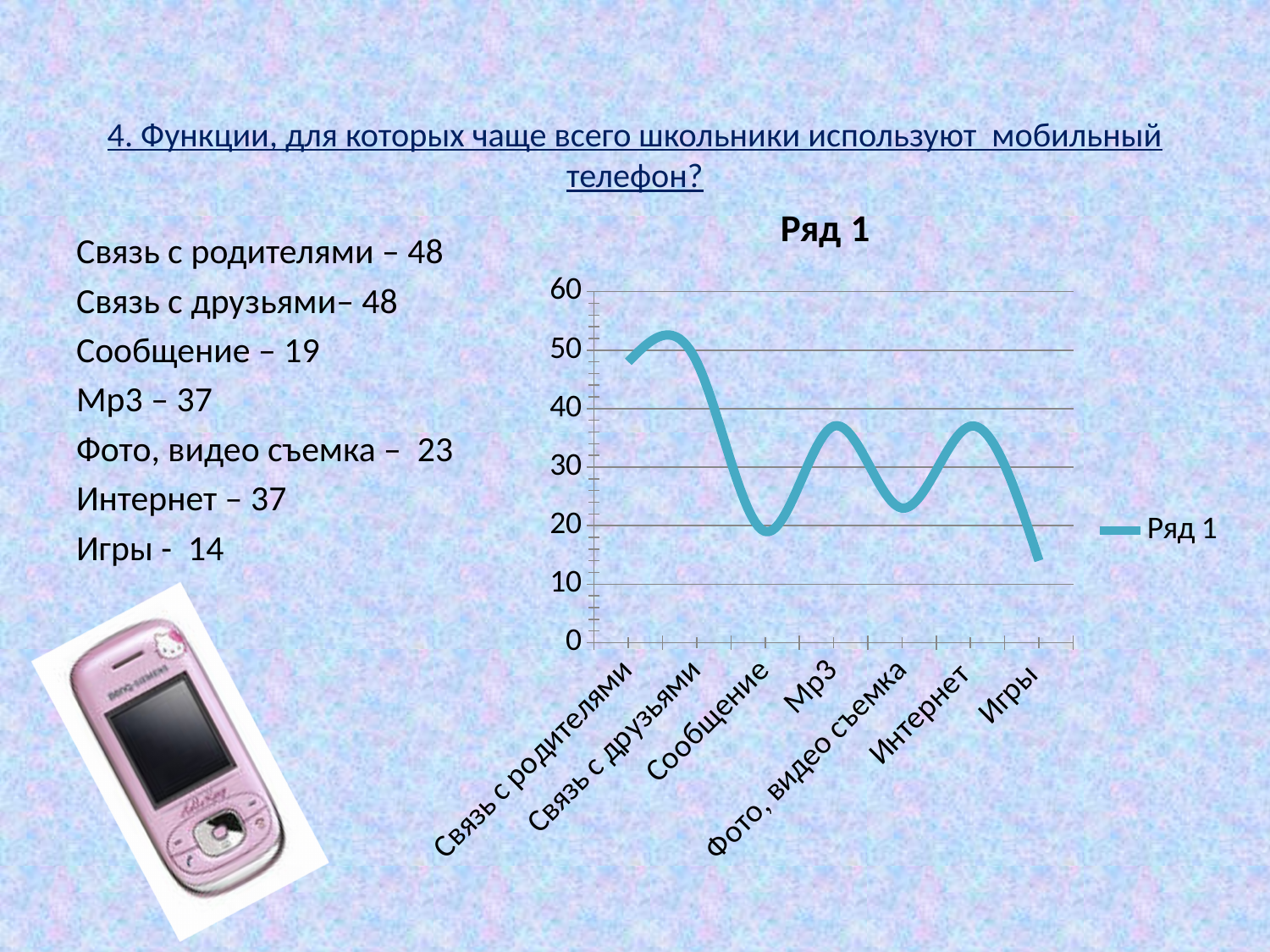
What is the value for Сообщение? 19 What kind of chart is shown on the slide? line chart Which is larger, the value for Mp3 or the value for Сообщение? Mp3 What is the title of the chart? Ряд 1 What is the difference between the values for Связь с родителями and Игры? 34 Is the value for Игры greater or less than 20? less Which category has the lowest value? Игры Is the value for Связь с друзьями greater or less than 40? greater What is the value for Фото, видео съемка? 23 How many series does the chart legend list? 1 How many categories are plotted along the x axis of the chart? 7 What is the value for Игры? 14